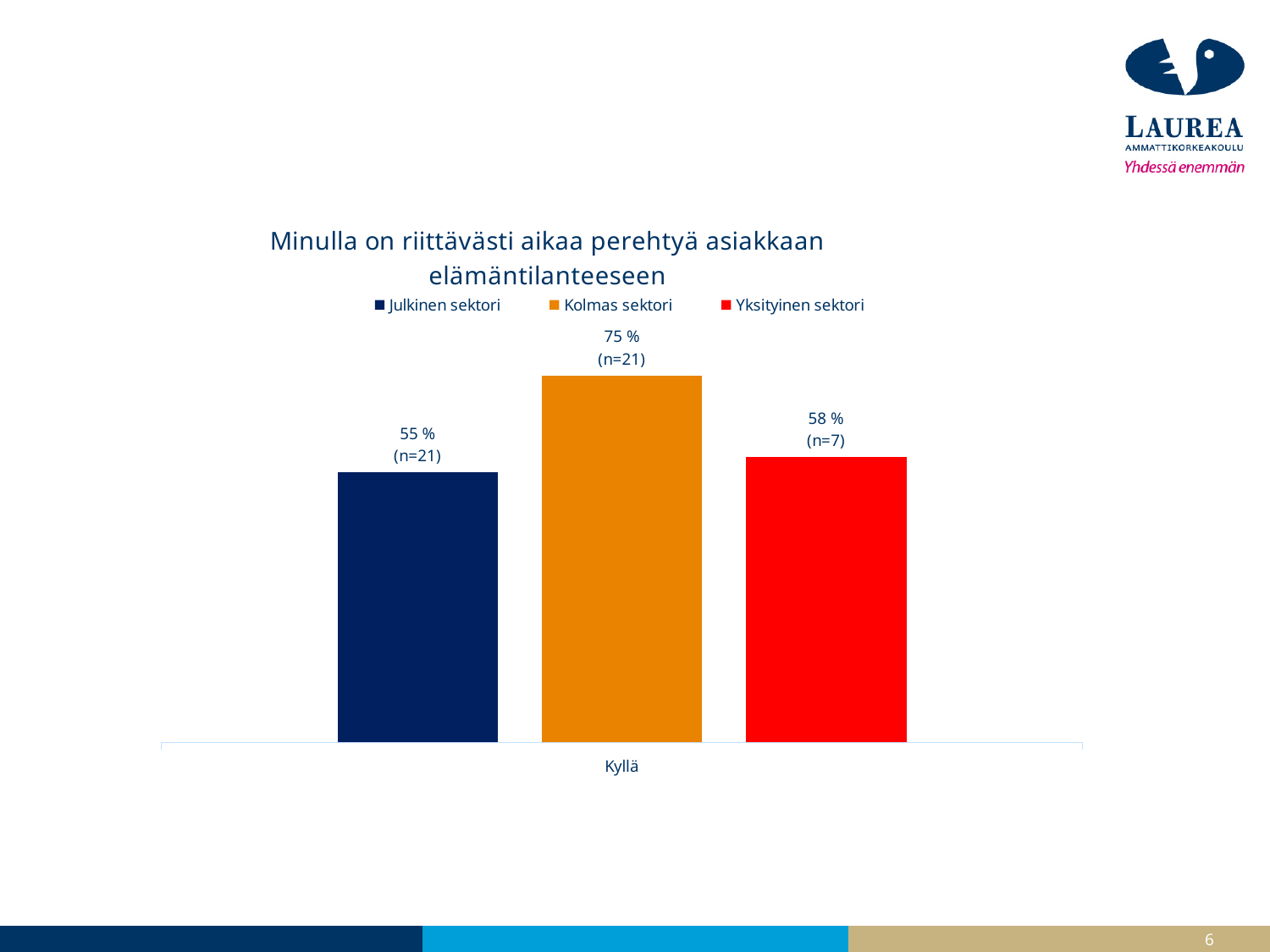
Which series has the highest value? Kolmas sektori What kind of chart is shown? Bar chart What is the sample size (n) shown for Yksityinen sektori? n=7 What is the value for Yksityinen sektori? 58 % What is the value for Julkinen sektori? 55 % Which series has the lowest value? Julkinen sektori What is the difference between the values for Yksityinen sektori and Julkinen sektori? 3 % What is the category label on the x axis? Kyllä How many series does the legend list? 3 What is the value for Kolmas sektori? 75 % What is the difference between the values for Kolmas sektori and Julkinen sektori? 20 % Which is larger, the value for Kolmas sektori or the value for Yksityinen sektori? Kolmas sektori